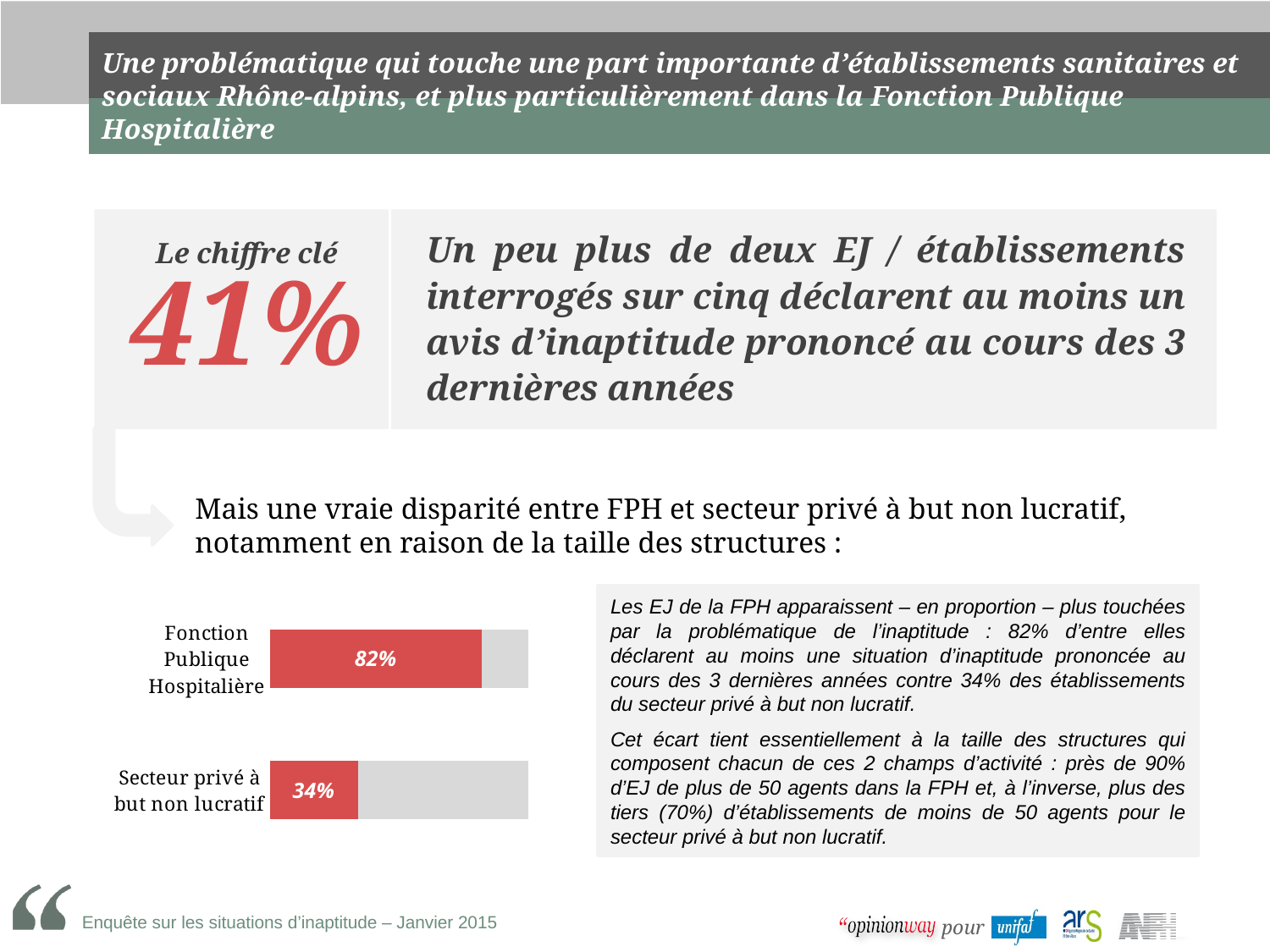
What is the value for Secteur privé à but non lucratif? 34% How many categories are shown in the chart? 2 What is the difference between the values for Fonction Publique Hospitalière and Secteur privé à but non lucratif? 48% Are the bars in the chart horizontal or vertical? Horizontal What colour are the filled portions of the bars? Red What is the value for Fonction Publique Hospitalière? 82% What kind of chart is shown on the slide? Bar chart Which category has the lowest value? Secteur privé à but non lucratif Which is larger, the value for Fonction Publique Hospitalière or the value for Secteur privé à but non lucratif? Fonction Publique Hospitalière Which category has the highest value? Fonction Publique Hospitalière